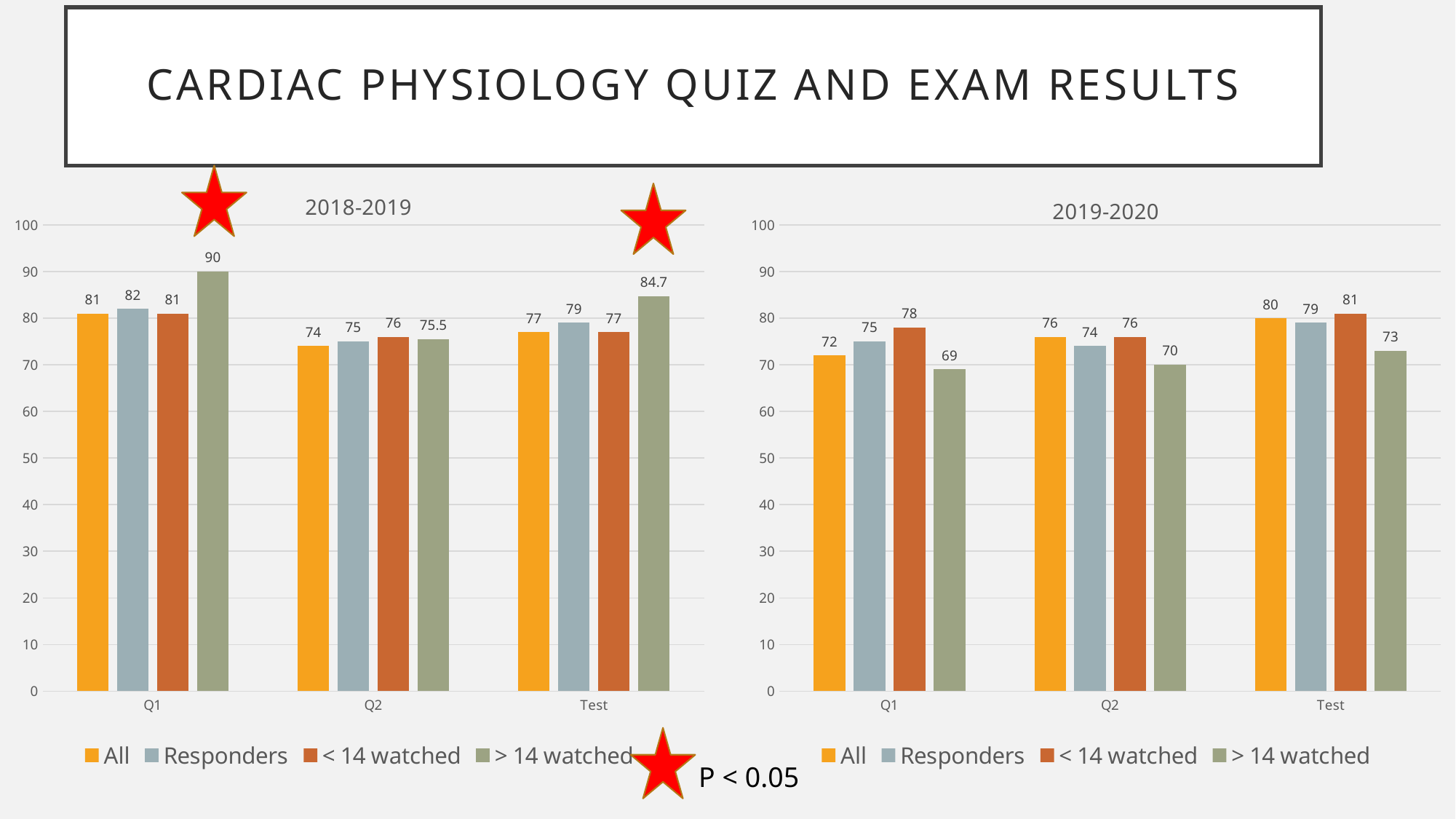
How many categories are shown on the x axis of the 2019-2020 chart? 3 In the 2019-2020 chart, what is the value for < 14 watched at Q1? 78 In the 2018-2019 chart, which series has the highest value at Q1? > 14 watched In the 2019-2020 chart, what is the difference between the < 14 watched and > 14 watched values at Test? 8 In the 2019-2020 chart, which is larger at Q2: All or Responders? All What kind of chart is the 2019-2020 chart? Bar chart In the 2019-2020 chart, which series has the lowest value at Q1? > 14 watched In the 2019-2020 chart, what is the value for > 14 watched at Test? 73 In the 2018-2019 chart, what is the value for > 14 watched at Q1? 90 In the 2018-2019 chart, what is the difference between the > 14 watched and All values at Q1? 9 How many series does the legend of the 2018-2019 chart list? 4 In the 2018-2019 chart, what is the value for > 14 watched at Test? 84.7